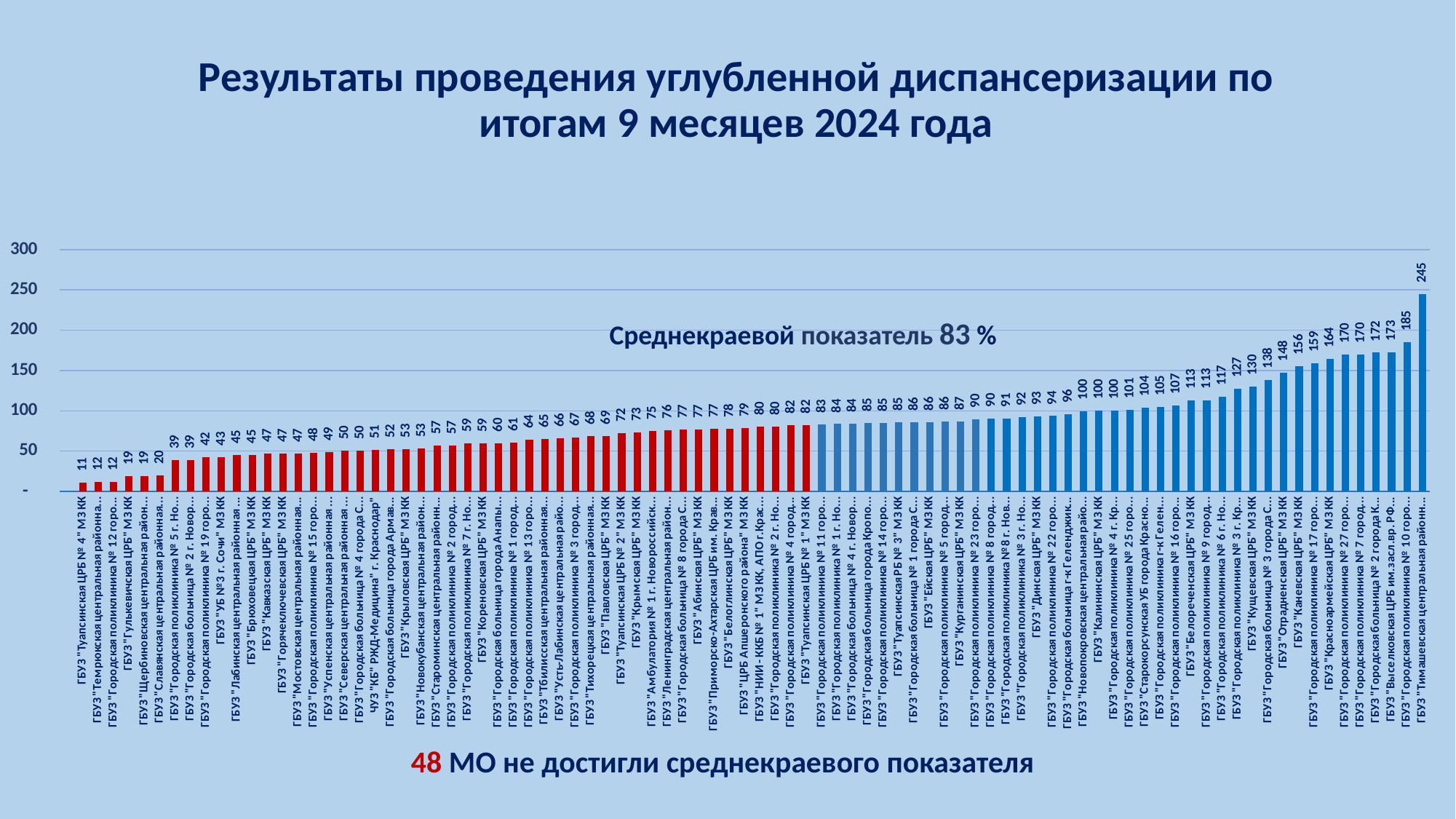
Which has a larger value, ГБУЗ "Крымская ЦРБ" МЗ КК or ГБУЗ "Павловская ЦРБ" МЗ КК? ГБУЗ "Крымская ЦРБ" МЗ КК What is the difference between the values for ГБУЗ "Красноармейская ЦРБ" МЗ КК and ГБУЗ "Ейская ЦРБ" МЗ КК? 78 Which organization has the lowest value on the chart? ГБУЗ "Туапсинская ЦРБ № 4" МЗ КК What is the value for ГБУЗ "Кавказская ЦРБ" МЗ КК? 47 Do the values rise or fall from left to right along the x axis? rise What is the value for ГБУЗ "Кущевская ЦРБ" МЗ КК? 130 What is the value for ГБУЗ "Белореченская ЦРБ" МЗ КК? 113 What is the highest value shown on the chart? 245 Which organization has the highest value on the chart? ГБУЗ "Тимашевская центральная районная..." What is the regional average indicator (среднекраевой показатель) stated on the chart? 83 % What is the value for ГБУЗ "Каневская ЦРБ" МЗ КК? 156 What kind of chart is shown on the slide? bar chart